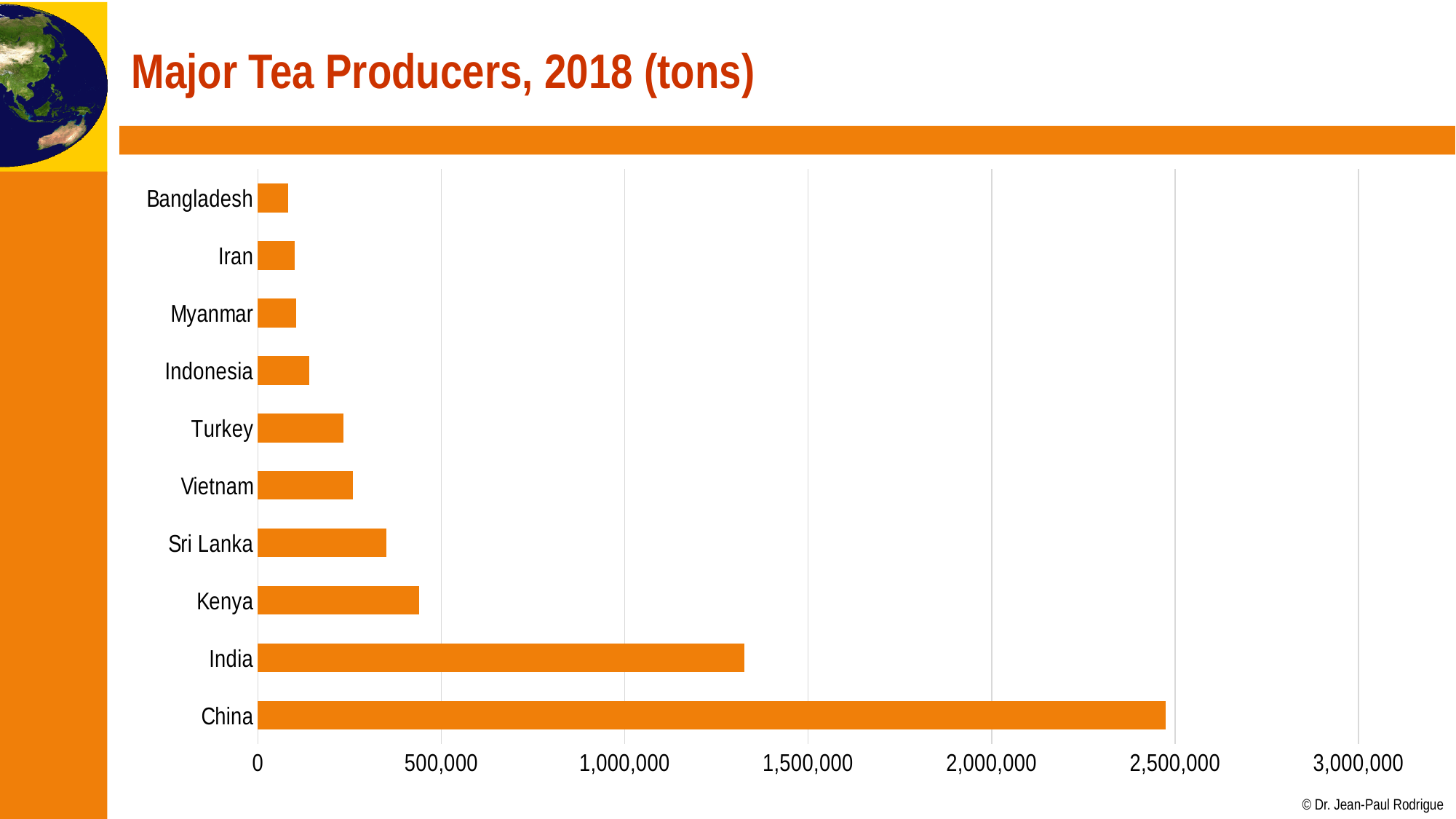
What is the title of the chart? Major Tea Producers, 2018 (tons) Is the value for Kenya greater or less than 500,000? less How many countries are shown in the chart? 10 Is the value for China greater or less than 2,000,000? greater Which country has the lowest tea production in the chart? Bangladesh Which country produces more tea, Sri Lanka or Vietnam? Sri Lanka Is the value for India greater or less than 1,000,000? greater Which country produces more tea, India or Kenya? India Which country has the highest tea production in the chart? China What kind of chart is shown on the slide? Bar chart Which country produces more tea, Indonesia or Turkey? Turkey